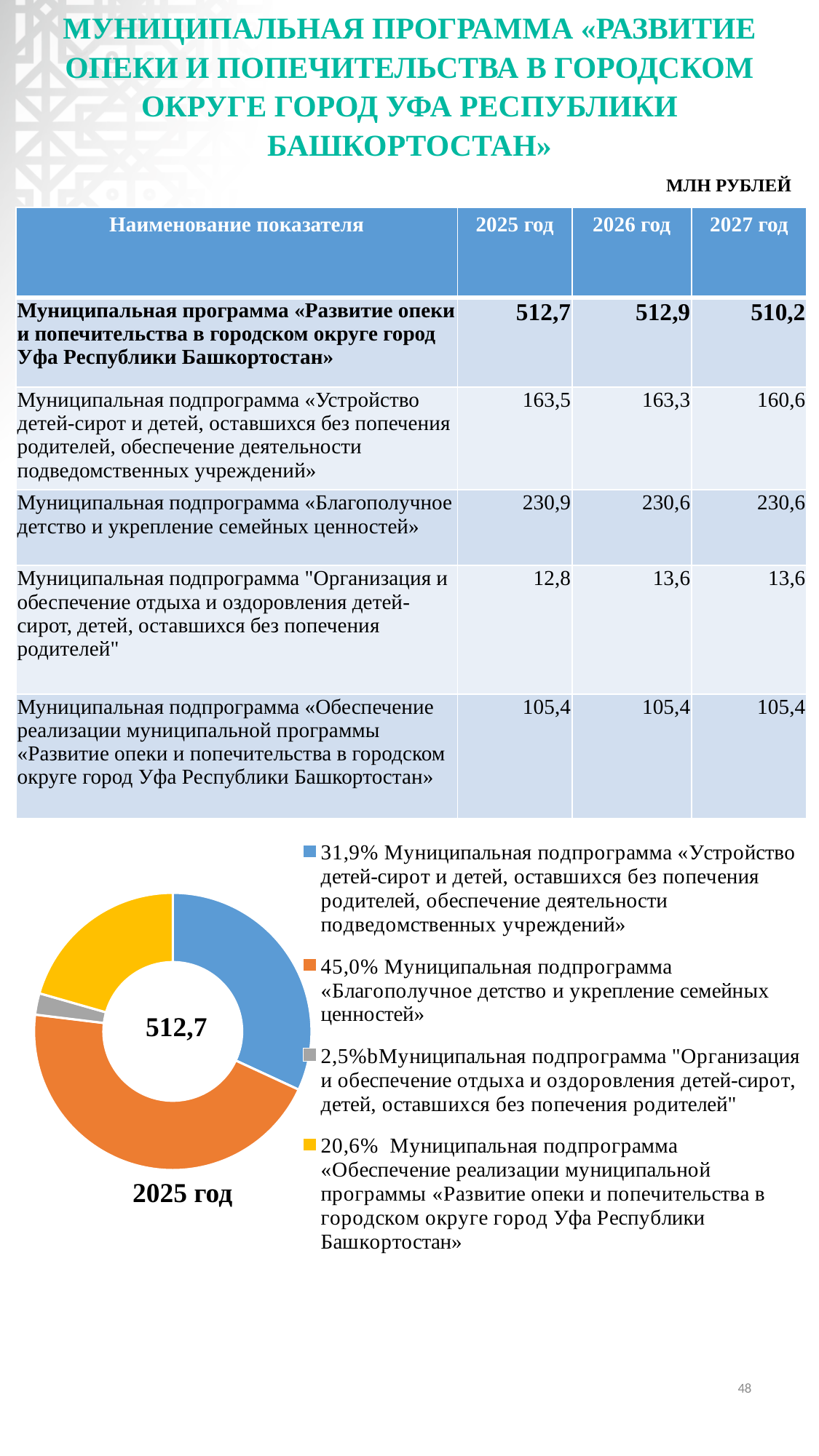
Which subprogram has the largest slice in the doughnut chart? Муниципальная подпрограмма «Благополучное детство и укрепление семейных ценностей» Which year does the doughnut chart represent, according to the label below it? 2025 год In the doughnut chart, which slice is larger: the one for «Устройство детей-сирот...» (blue) or the one for «Обеспечение реализации муниципальной программы...» (yellow)? «Устройство детей-сирот...» (blue) What kind of chart is shown at the bottom of the slide? Doughnut chart What share of the doughnut chart does the subprogram "Организация и обеспечение отдыха и оздоровления детей-сирот, детей, оставшихся без попечения родителей" take? 2,5% What share of the doughnut chart does the subprogram «Благополучное детство и укрепление семейных ценностей» take? 45,0% What share of the doughnut chart does the subprogram «Обеспечение реализации муниципальной программы «Развитие опеки и попечительства в городском округе город Уфа Республики Башкортостан»» take? 20,6% Which subprogram has the smallest slice in the doughnut chart? Муниципальная подпрограмма "Организация и обеспечение отдыха и оздоровления детей-сирот, детей, оставшихся без попечения родителей" How many slices does the doughnut chart have? 4 What total value is printed in the centre of the doughnut chart? 512,7 What is the difference in percentage points between the 45,0% slice and the 31,9% slice in the doughnut chart? 13,1